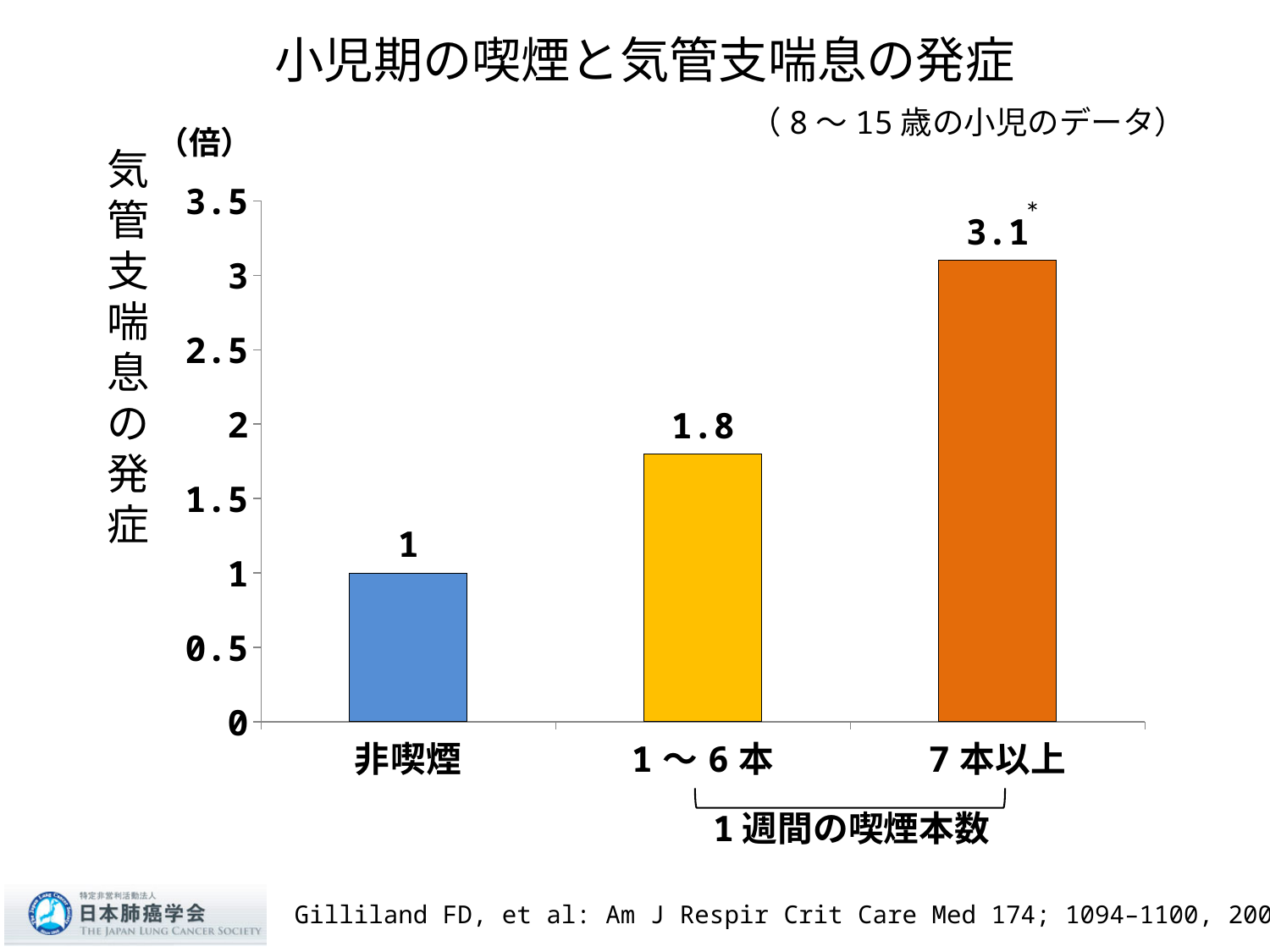
Is the value for 7本以上 greater or less than 3? greater Which category has the lowest value? 非喫煙 What is the value for 1～6本? 1.8 What is the value for 7本以上? 3.1 What is the value for 非喫煙? 1 What is the difference between the values for 7本以上 and 1～6本? 1.3 Which is larger, the value for 1～6本 or the value for 非喫煙? 1～6本 What is the difference between the values for 1～6本 and 非喫煙? 0.8 What kind of chart is shown on the slide? bar chart How many categories are shown on the x axis? 3 Do the values rise or fall from left to right along the x axis? rise Which category has the highest value? 7本以上